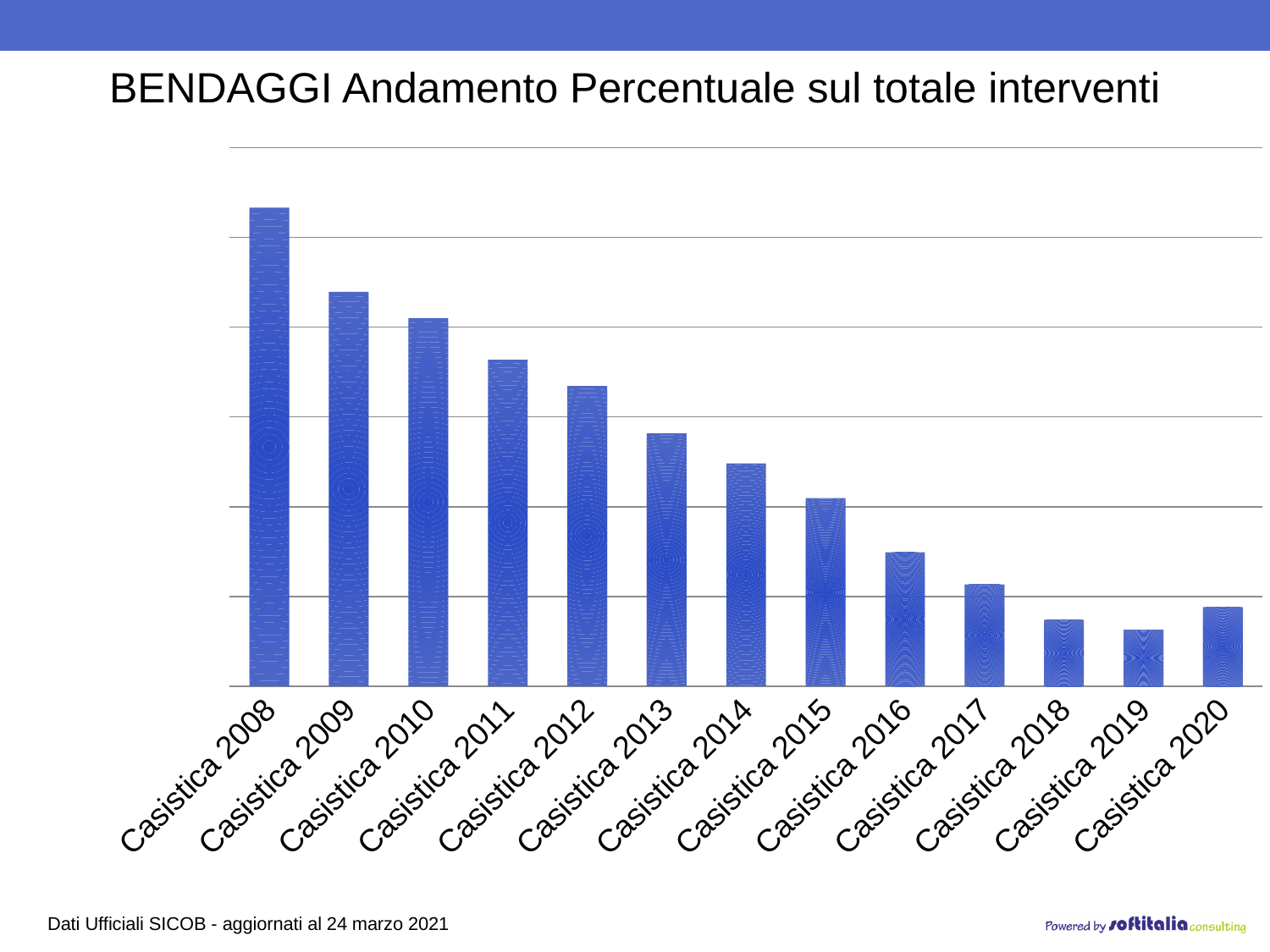
What kind of chart is shown on the slide? bar chart Which is larger, the value for Casistica 2008 or Casistica 2009? Casistica 2008 Does the value rise or fall from Casistica 2019 to Casistica 2020? rise What is the first category on the x axis? Casistica 2008 Do the values generally rise or fall from Casistica 2008 to Casistica 2019? fall What is the title of the chart? BENDAGGI Andamento Percentuale sul totale interventi Which is larger, the value for Casistica 2017 or Casistica 2020? Casistica 2017 Which category has the highest value? Casistica 2008 How many categories (bars) are plotted in the chart? 13 Which is larger, the value for Casistica 2015 or Casistica 2016? Casistica 2015 Which category has the lowest value? Casistica 2019